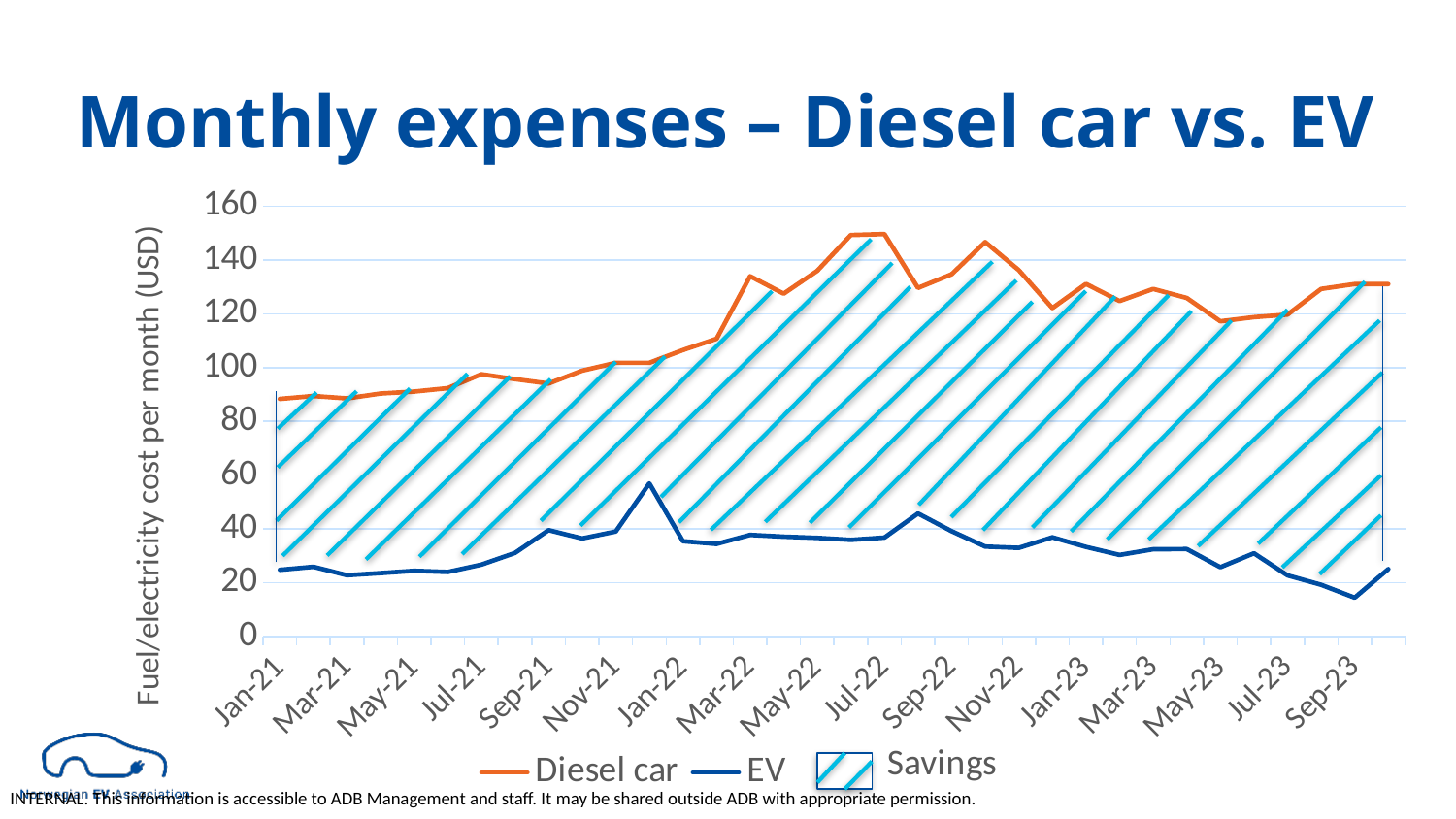
Is the value for EV in Jan-22 greater or less than 40? less Is the value for Diesel car in Jan-21 greater or less than 100? less Is the value for EV in Sep-23 greater or less than 20? less In which month does the EV series reach its highest value? Dec-21 What is the label on the vertical axis? Fuel/electricity cost per month (USD) How many entries does the legend list? 3 What is the title of the chart? Monthly expenses – Diesel car vs. EV What kind of chart is shown on the slide? Line chart Which series has the higher value in Jul-22, Diesel car or EV? Diesel car Does the Diesel car series generally rise or fall from Jan-21 to Jul-22? Rise